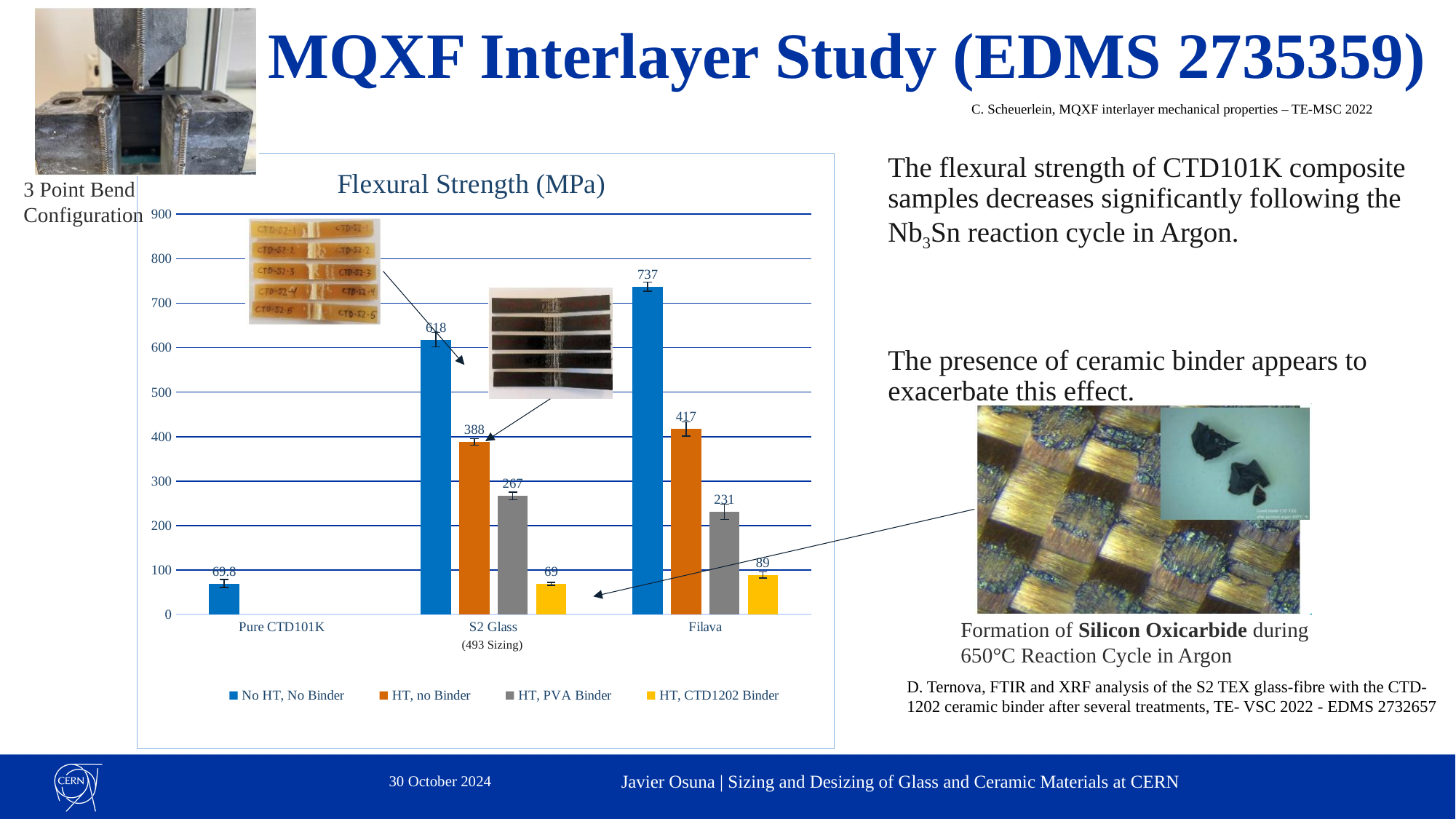
What kind of chart is shown? Bar chart Which is larger: the HT, PVA Binder value for S2 Glass or for Filava? S2 Glass What is the difference between the HT, no Binder and HT, PVA Binder values for S2 Glass? 121 Which category has the highest flexural strength for the No HT, No Binder series? Filava What is the flexural strength of S2 Glass with HT, PVA Binder? 267 Which series has the lowest flexural strength for Filava? HT, CTD1202 Binder How many series does the legend list? 4 What is the flexural strength of Filava with No HT, No Binder? 737 What is the flexural strength of Pure CTD101K? 69.8 What is the title of the chart? Flexural Strength (MPa) What is the flexural strength of S2 Glass with HT, CTD1202 Binder? 69 What is the difference in flexural strength between Filava and S2 Glass for the No HT, No Binder series? 119